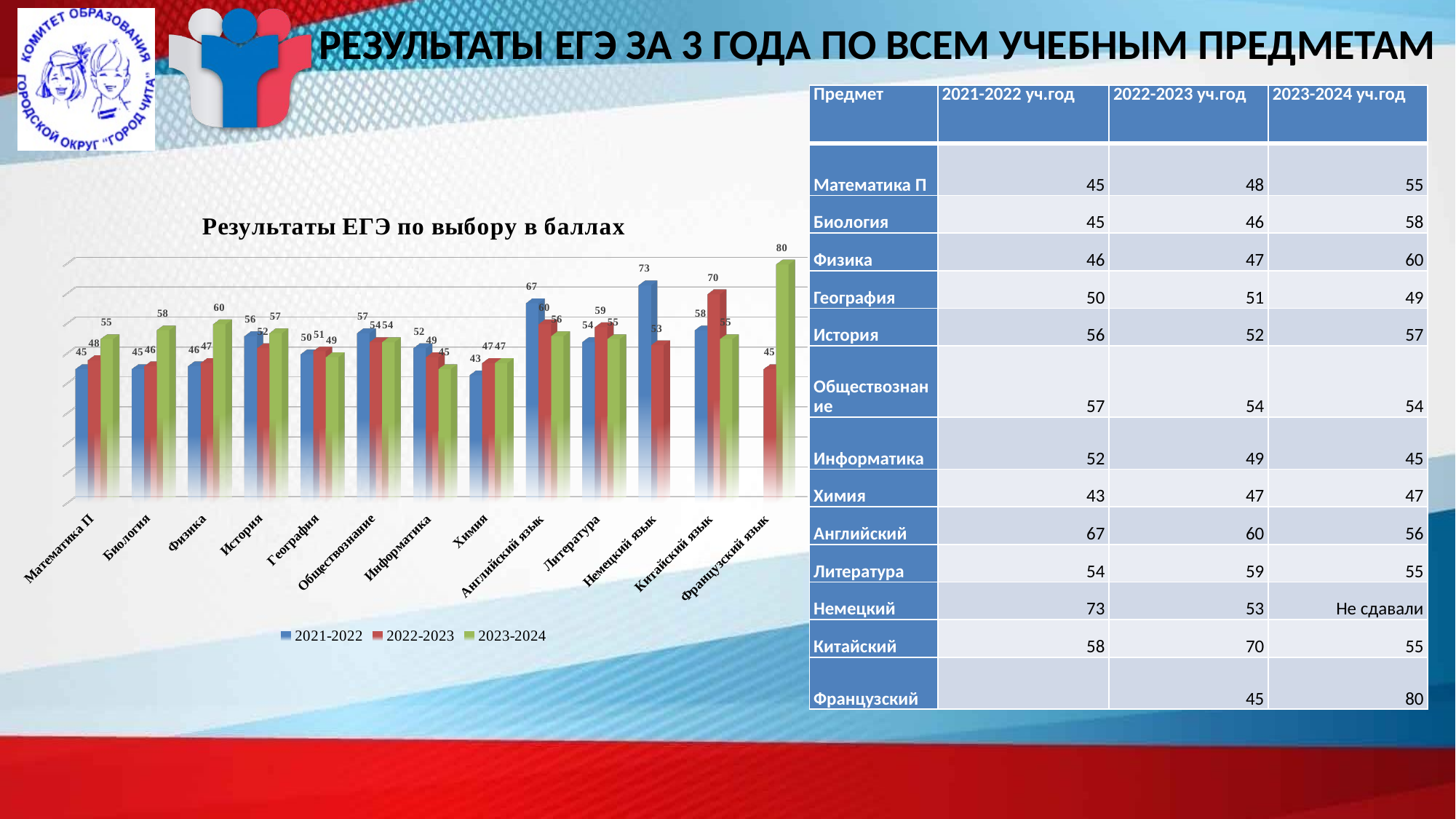
What is the difference between the 2023-2024 and 2021-2022 values for Математика П in the chart? 10 How many series does the chart legend list? 3 What type of chart is shown on the slide? bar chart What is the 2022-2023 value for Китайский язык in the chart? 70 What is the 2023-2024 value for Физика in the chart? 60 Which is larger in the chart: the 2022-2023 value for Литература or the 2022-2023 value for История? Литература How do the values for Информатика change across the three years in the chart? fall What is the 2021-2022 value for Английский язык in the chart? 67 How many subject categories are shown on the x axis of the chart? 13 What is the title of the chart? Результаты ЕГЭ по выбору в баллах Which subject has the highest 2021-2022 value in the chart? Немецкий язык Which subject has the lowest 2021-2022 value in the chart? Химия